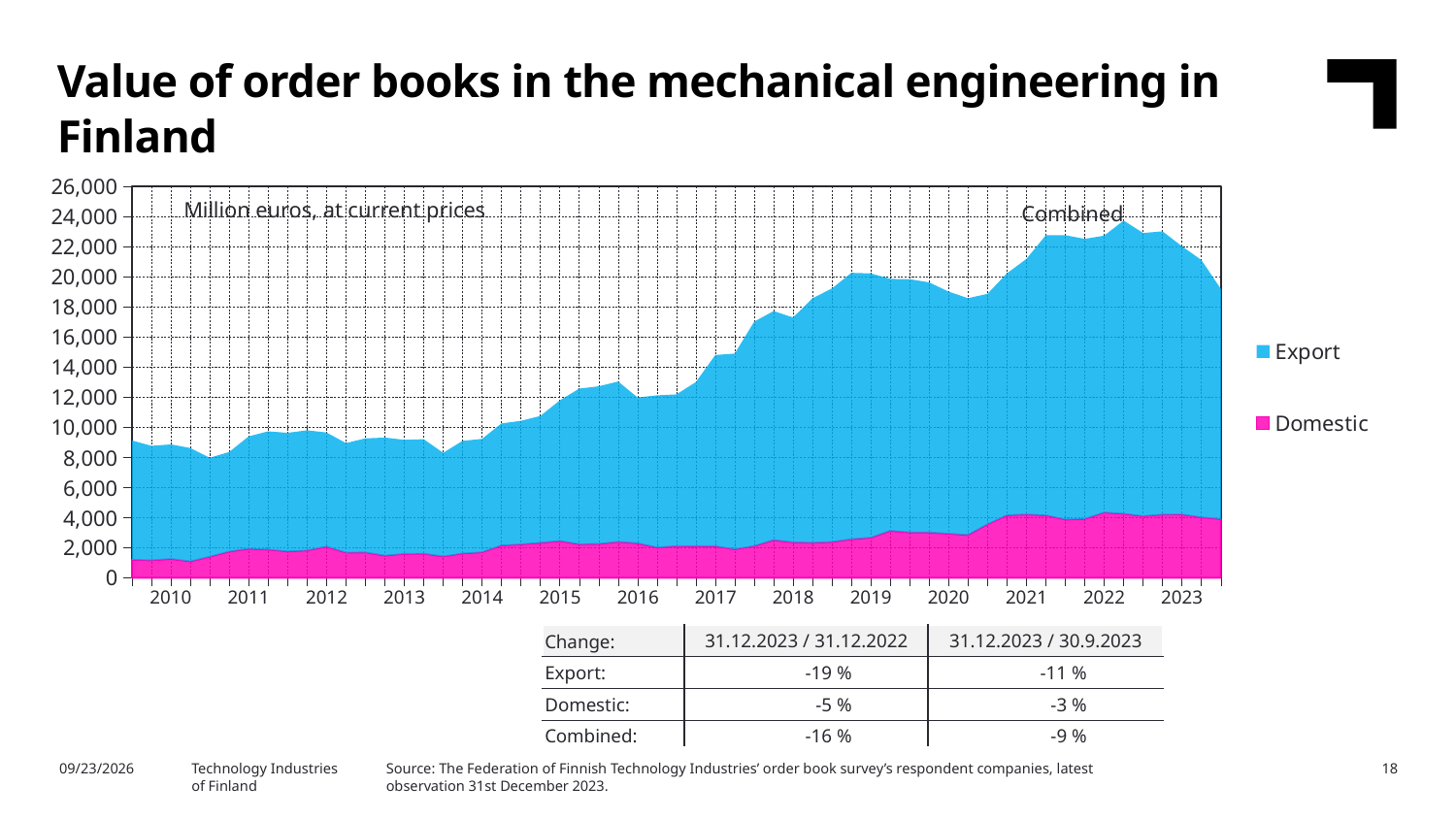
Is the combined value at the end of 2023 greater or less than 18,000? greater Does the combined value of order books generally rise or fall from 2010 to 2022? rise How many year labels appear on the x axis of the chart? 14 What kind of chart is shown on the slide? Stacked area chart Which two series are listed in the chart legend? Export and Domestic Is the combined value of order books at the start of 2010 greater or less than 10,000? less Is the peak combined value of order books around 2022 greater or less than 22,000? greater How many series does the legend list? 2 What unit is stated for the values in the chart? Million euros, at current prices Which series is larger throughout the chart, Export or Domestic? Export